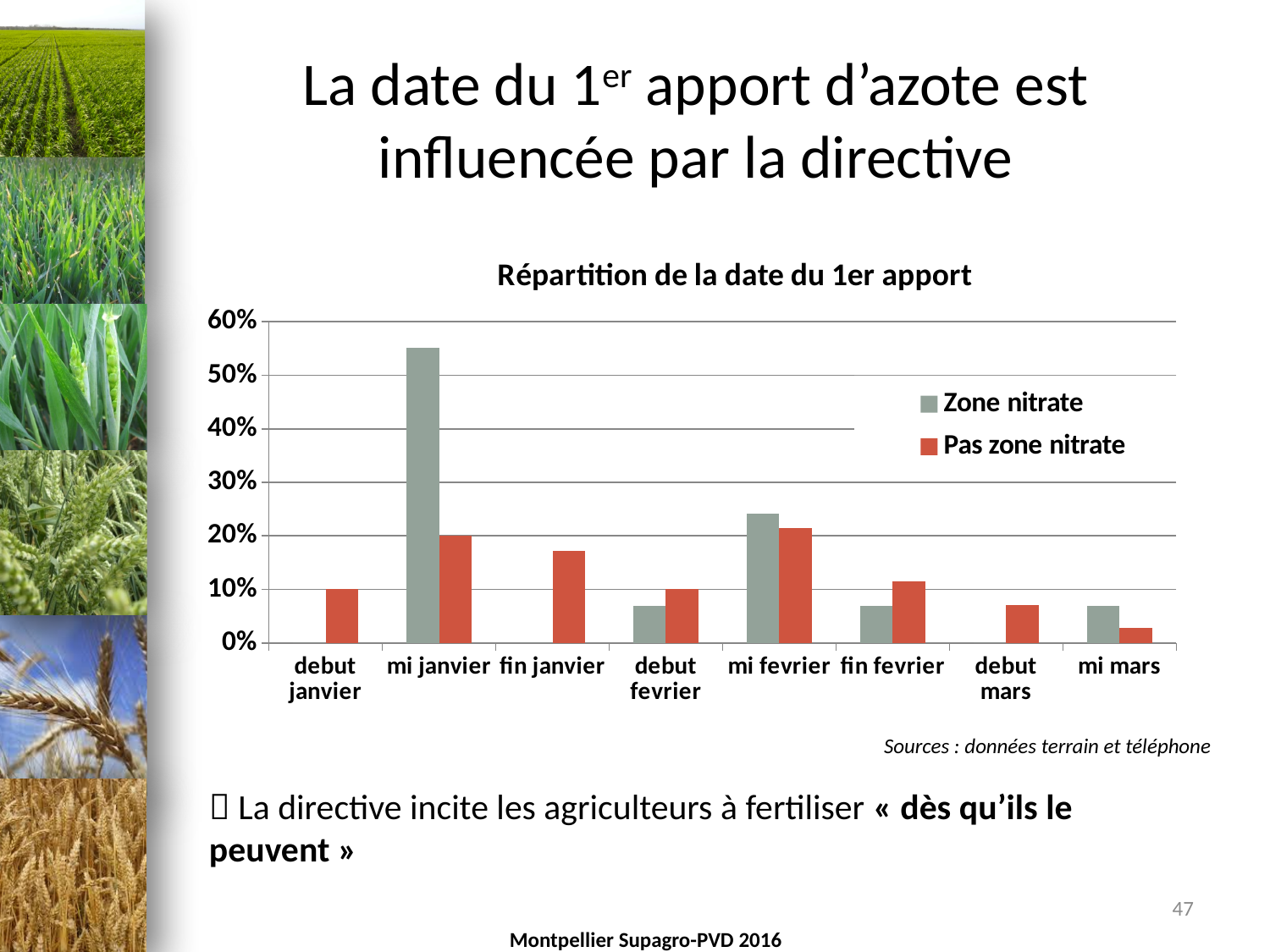
Which category has the lowest non-zero value for the Pas zone nitrate series? mi mars Is the Zone nitrate value for mi janvier greater or less than 50%? greater What is the title of the chart? Répartition de la date du 1er apport Is the Zone nitrate value for mi fevrier greater or less than 20%? greater Is the Pas zone nitrate value for fin janvier greater or less than 20%? less How many series does the legend of the chart list? 2 Which category has the highest value for the Zone nitrate series? mi janvier What kind of chart is shown on the slide? bar chart For mi janvier, which series has the larger value, Zone nitrate or Pas zone nitrate? Zone nitrate How many categories are shown on the x axis of the chart? 8 For fin fevrier, which series has the larger value, Zone nitrate or Pas zone nitrate? Pas zone nitrate What colour are the bars for the Pas zone nitrate series? red